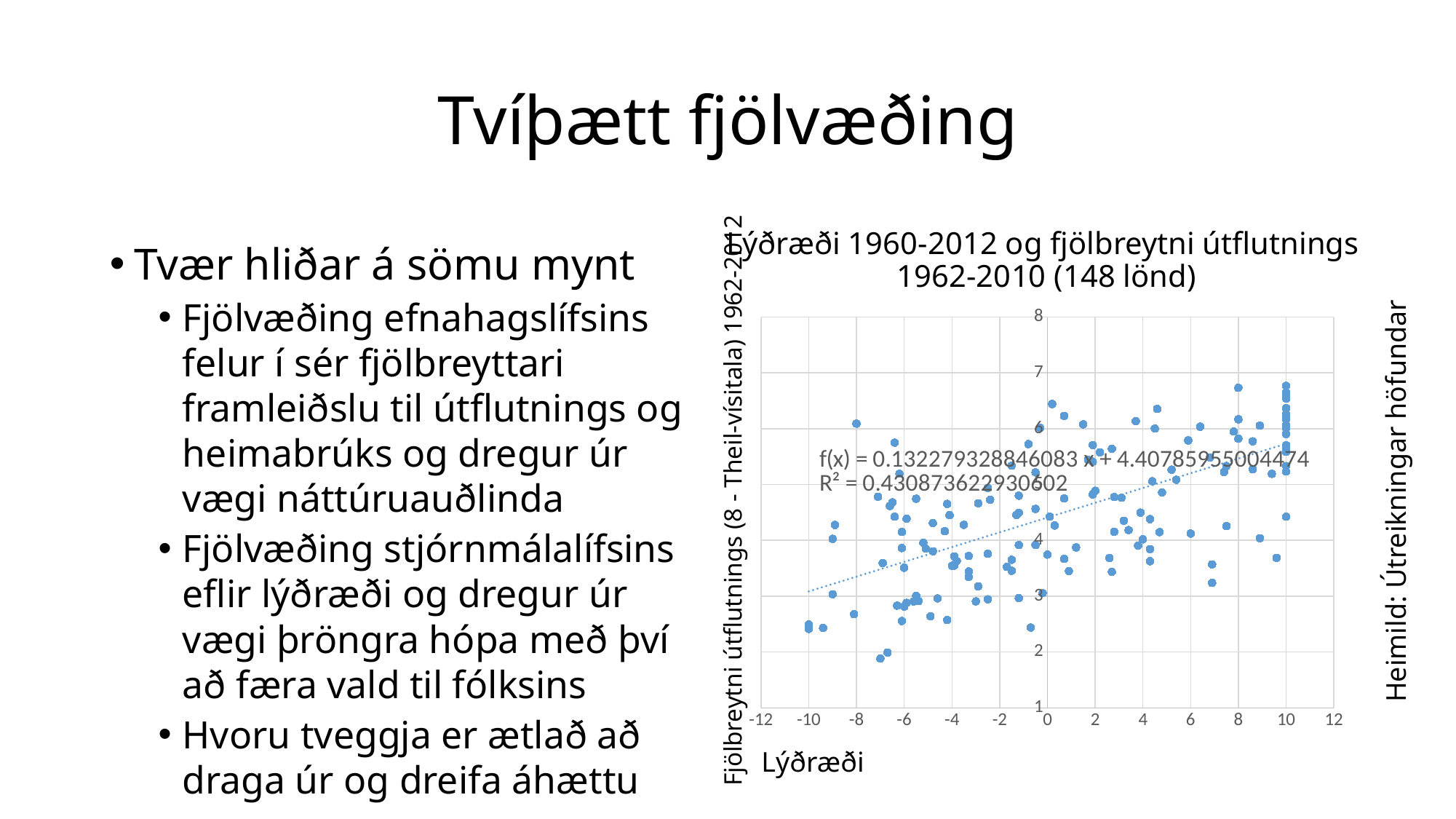
What is the lowest tick value shown on the x axis of the chart? -12 Is the R² value shown on the chart greater or less than 0.5? less What is the R² value shown on the chart? 0.430873622930602 What is the label of the x axis of the chart? Lýðræði What kind of chart is shown on the slide? Scatter chart What is the intercept of the trendline shown on the chart? 4.40785955004474 How many countries does the chart title say are included? 148 What is the title of the chart? Lýðræði 1960-2012 og fjölbreytni útflutnings 1962-2010 (148 lönd) According to the trendline, do the values of fjölbreytni útflutnings rise or fall as Lýðræði increases along the x axis? Rise What is the trendline equation shown on the chart? f(x) = 0.132279328846083 x + 4.40785955004474 What is the slope of the trendline shown on the chart? 0.132279328846083 What is the highest tick value shown on the y axis of the chart? 8